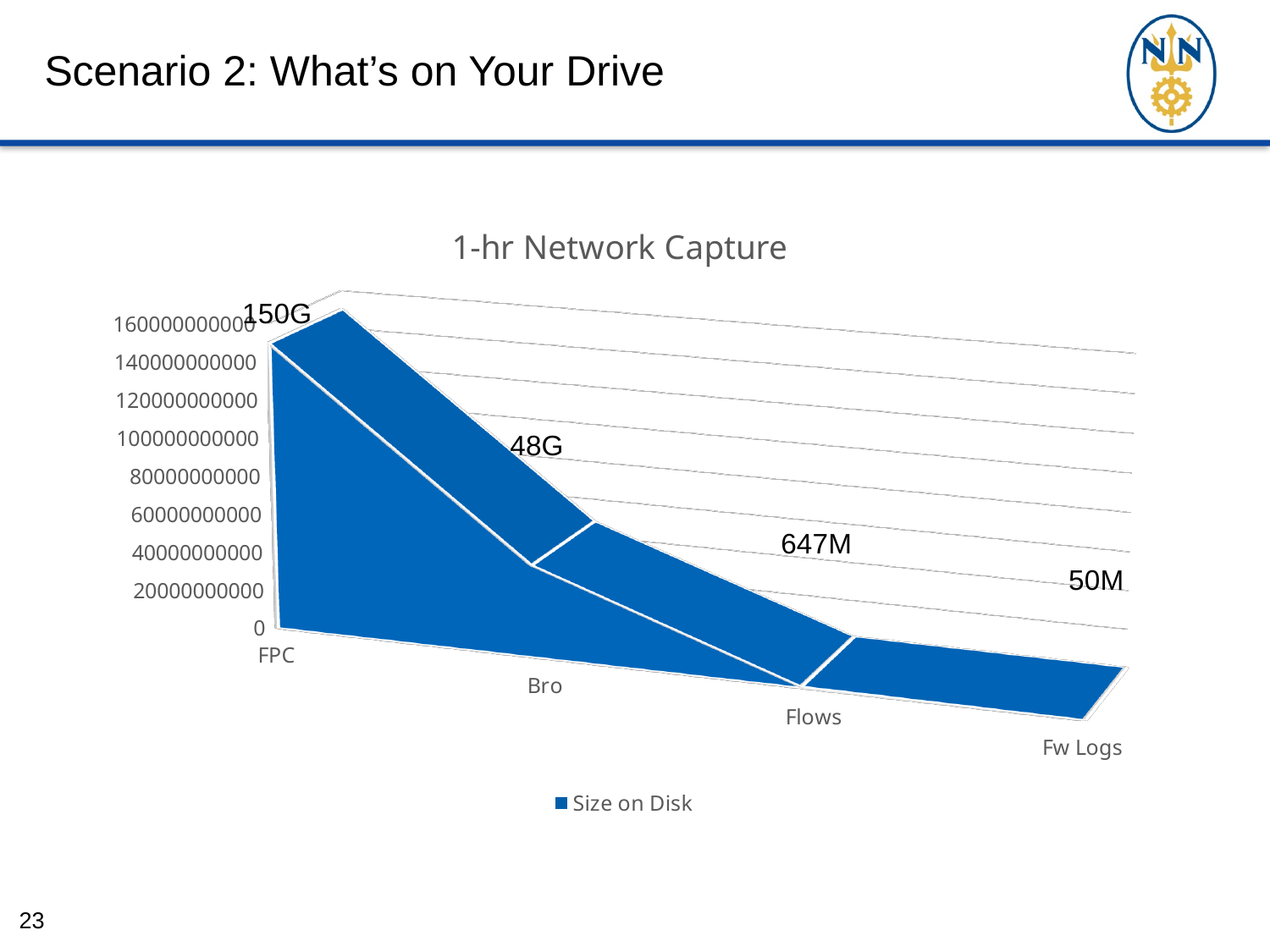
What is the Size on Disk value for FPC? 150G How many series does the legend list? 1 How many categories are plotted on the x axis? 4 What is the Size on Disk value for Bro? 48G What type of chart is shown on the slide? area chart What is the title of the chart? 1-hr Network Capture Which category has the largest Size on Disk? FPC What is the Size on Disk value for Fw Logs? 50M Do the values rise or fall from FPC to Fw Logs along the x axis? fall What is the Size on Disk value for Flows? 647M Which category has the smallest Size on Disk? Fw Logs Is the value for Bro greater or less than 60000000000? less